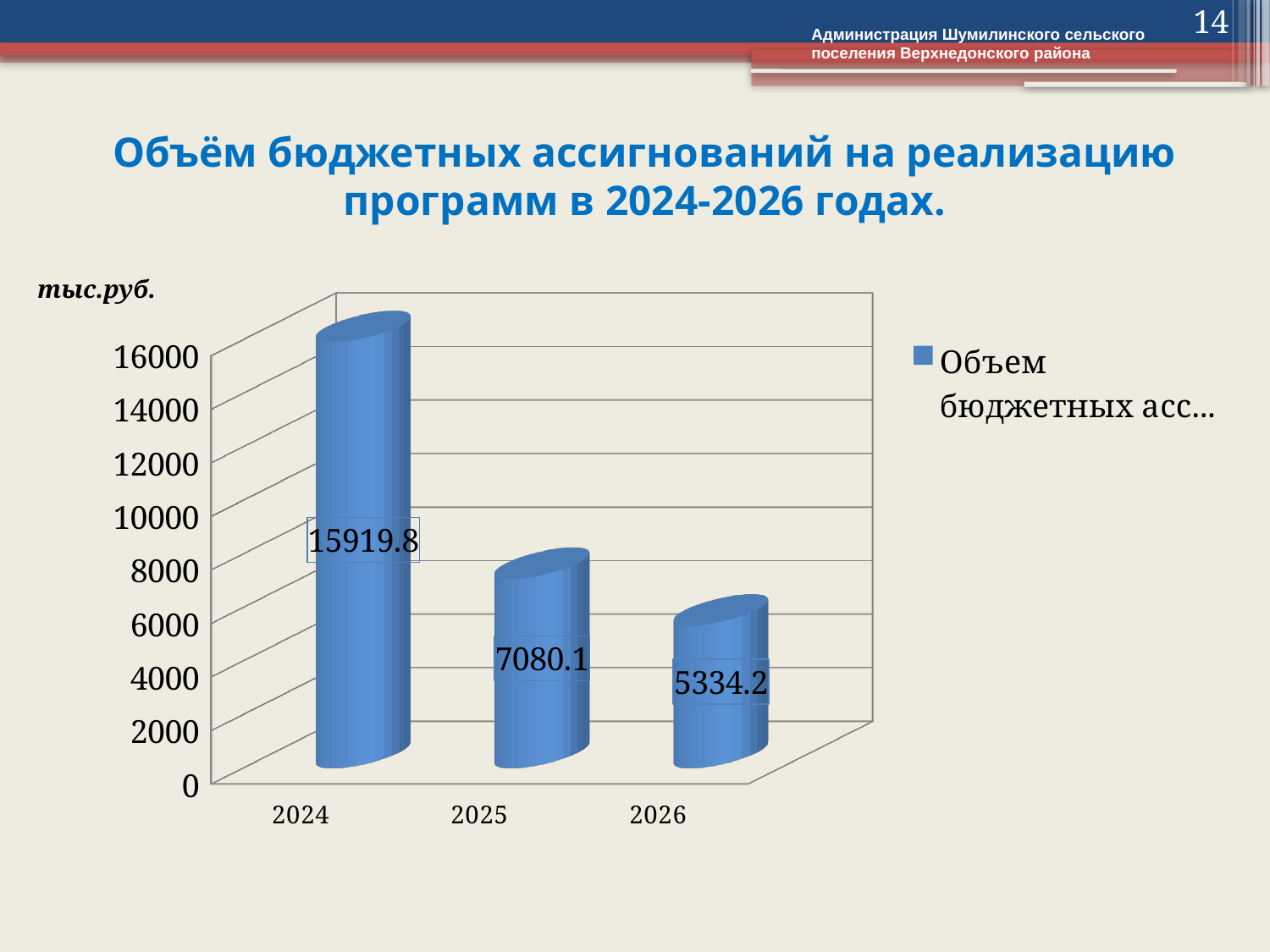
What is the value for 2026? 5334.2 What is the difference between the values for 2024 and 2025? 8839.7 What is the difference between the values for 2025 and 2026? 1745.9 How many years are shown on the x axis? 3 Is the value for 2024 greater or less than 14000? greater What is the value for 2024? 15919.8 Which is larger, the value for 2025 or the value for 2026? 2025 Which year has the highest value? 2024 What kind of chart is shown on the slide? bar chart Do the values rise or fall from 2024 to 2026? fall What is the value for 2025? 7080.1 Which year has the lowest value? 2026